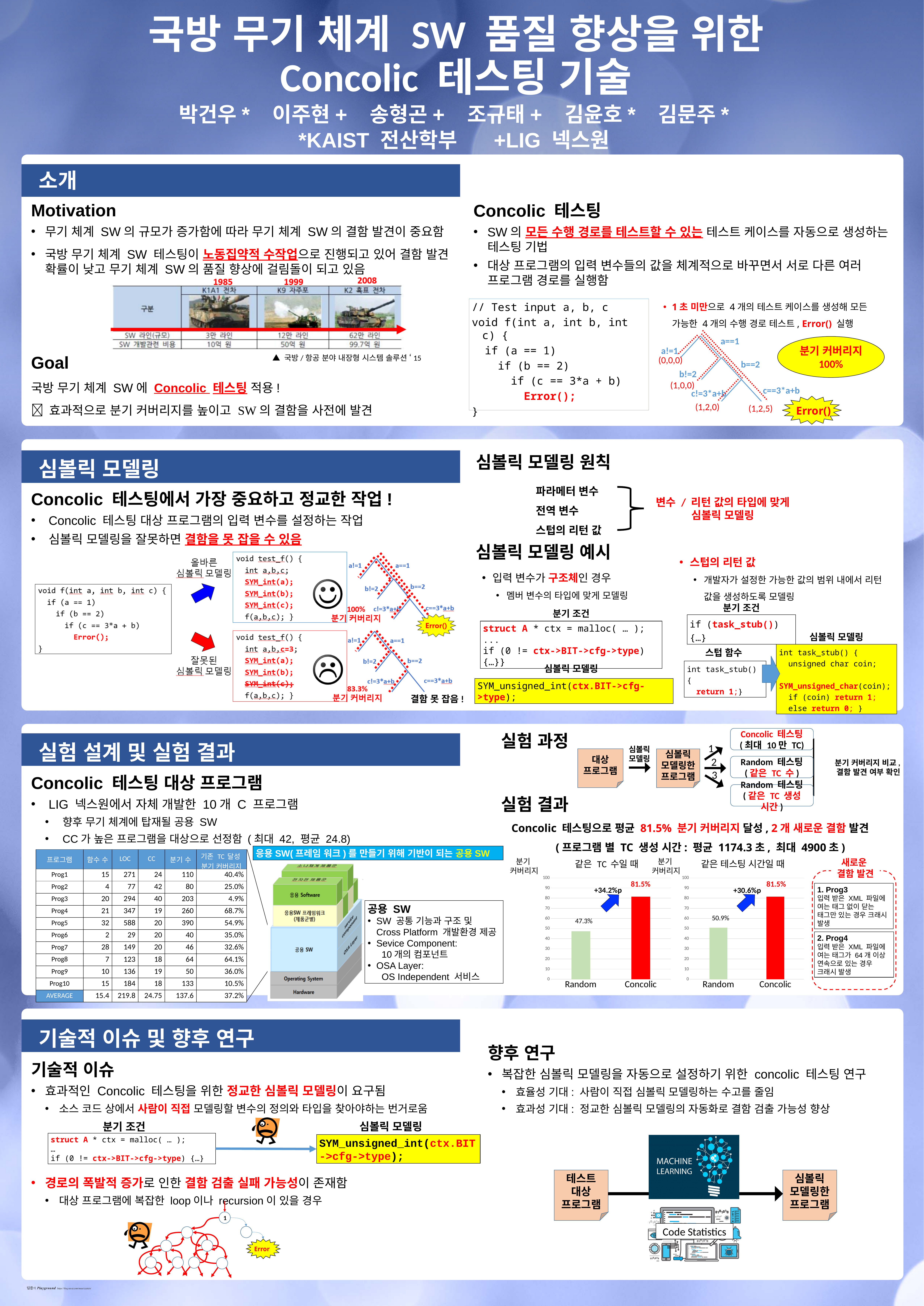
In the chart titled '같은 테스팅 시간일 때', what is the branch coverage value for Concolic? 81.5% In the chart titled '같은 TC 수일 때', what colour is the Concolic bar? red In the chart titled '같은 TC 수일 때', what is the branch coverage value for Random? 47.3% In the chart titled '같은 테스팅 시간일 때', what is the branch coverage value for Random? 50.9% How many categories are shown in the chart titled '같은 테스팅 시간일 때'? 2 In the chart titled '같은 TC 수일 때', which category has the higher branch coverage? Concolic In the chart titled '같은 테스팅 시간일 때', which category has the lower branch coverage? Random In the chart titled '같은 TC 수일 때', what is the branch coverage value for Concolic? 81.5% In the chart titled '같은 테스팅 시간일 때', what is the difference in percentage points between Concolic and Random? 30.6%p In the chart titled '같은 테스팅 시간일 때', is the value for Random greater or less than 60? less In the chart titled '같은 TC 수일 때', what is the difference in percentage points between Concolic and Random? 34.2%p What kind of chart is the chart titled '같은 TC 수일 때'? bar chart